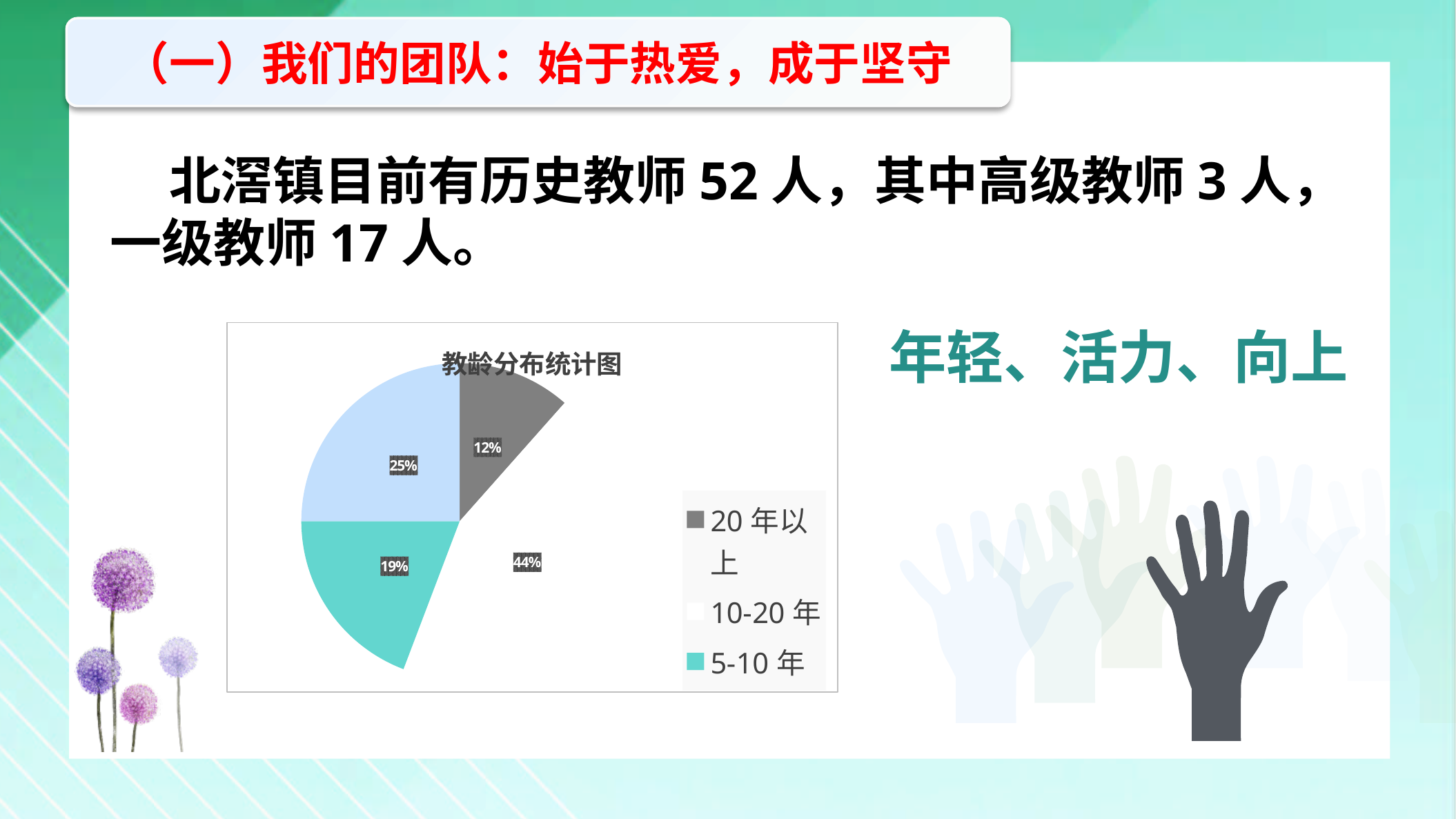
Which is larger, the 5-10 年 slice or the 20 年以上 slice? 5-10 年 Which category has the largest slice of the pie chart? 10-20 年 What kind of chart is shown on the slide? Pie chart What is the title of the pie chart? 教龄分布统计图 What percentage does the 5-10 年 slice show? 19% How many percentage points larger is the 10-20 年 slice than the 5-10 年 slice? 25 How many slices does the pie chart have? 4 Which category has the smallest slice of the pie chart? 20 年以上 How many percentage points larger is the 5-10 年 slice than the 20 年以上 slice? 7 What percentage does the 10-20 年 slice show? 44% What colour is the 5-10 年 slice in the pie chart? Teal What percentage of the pie chart is labelled for the 20 年以上 category? 12%